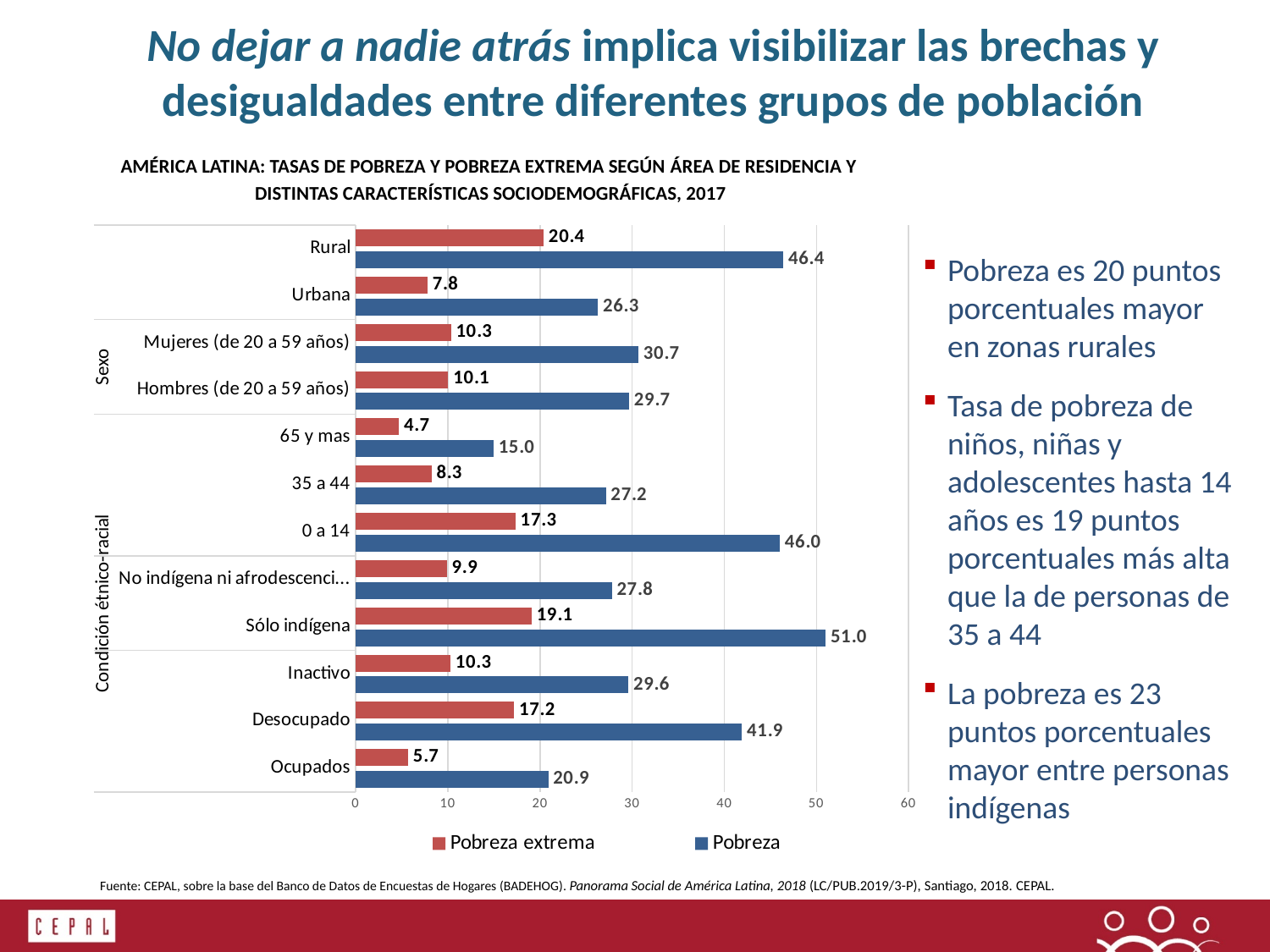
How many series does the legend list? 2 Is the Pobreza value for 0 a 14 greater or less than 40? greater What is the Pobreza value for Ocupados? 20.9 What is the Pobreza value for Rural? 46.4 Which colour represents Pobreza extrema in the chart? red What kind of chart is shown on the slide? bar chart Which is larger, the Pobreza value for Desocupado or for Inactivo? Desocupado What is the Pobreza extrema value for Sólo indígena? 19.1 Which category has the lowest Pobreza extrema value? 65 y mas Which category has the highest Pobreza value? Sólo indígena What is the difference between the Pobreza values for Rural and Urbana? 20.1 How many categories are shown on the chart? 12